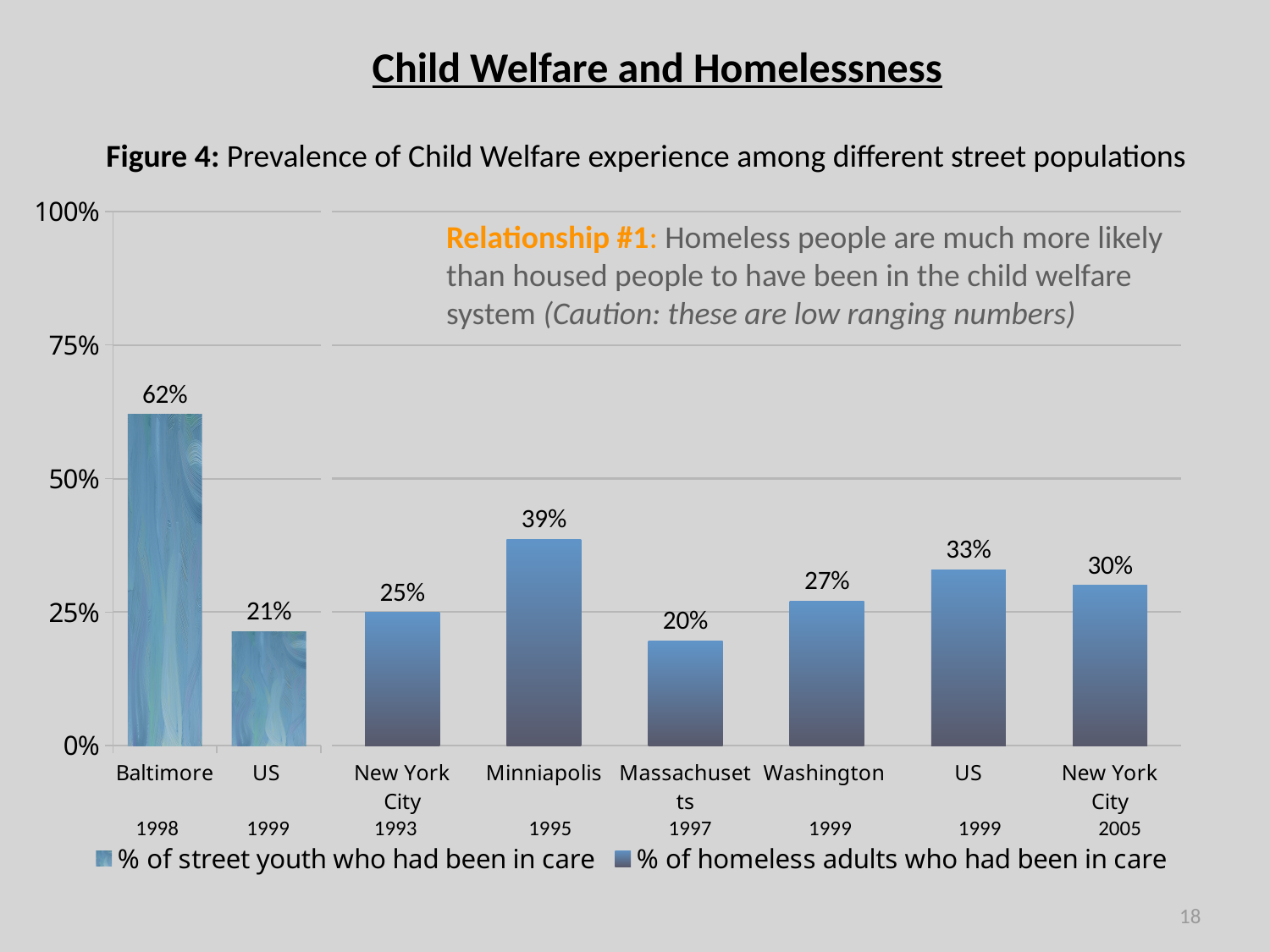
Which category has the lowest value in the chart? Massachusetts 1997 What is the value for Baltimore 1998 (% of street youth who had been in care)? 62% How many bars are plotted in the chart? 8 What is the value for New York City 2005? 30% What is the value for Minniapolis 1995 (% of homeless adults who had been in care)? 39% What is the difference between the values for Baltimore 1998 and US 1999 among street youth? 41% Is the value for US 1999 (% of homeless adults who had been in care) greater or less than 25%? greater How many series does the legend list? 2 What is the value for Massachusetts 1997? 20% Which is larger: the value for Washington 1999 or the value for New York City 1993? Washington 1999 Which category has the highest value in the chart? Baltimore 1998 What kind of chart is shown on the slide? Bar chart